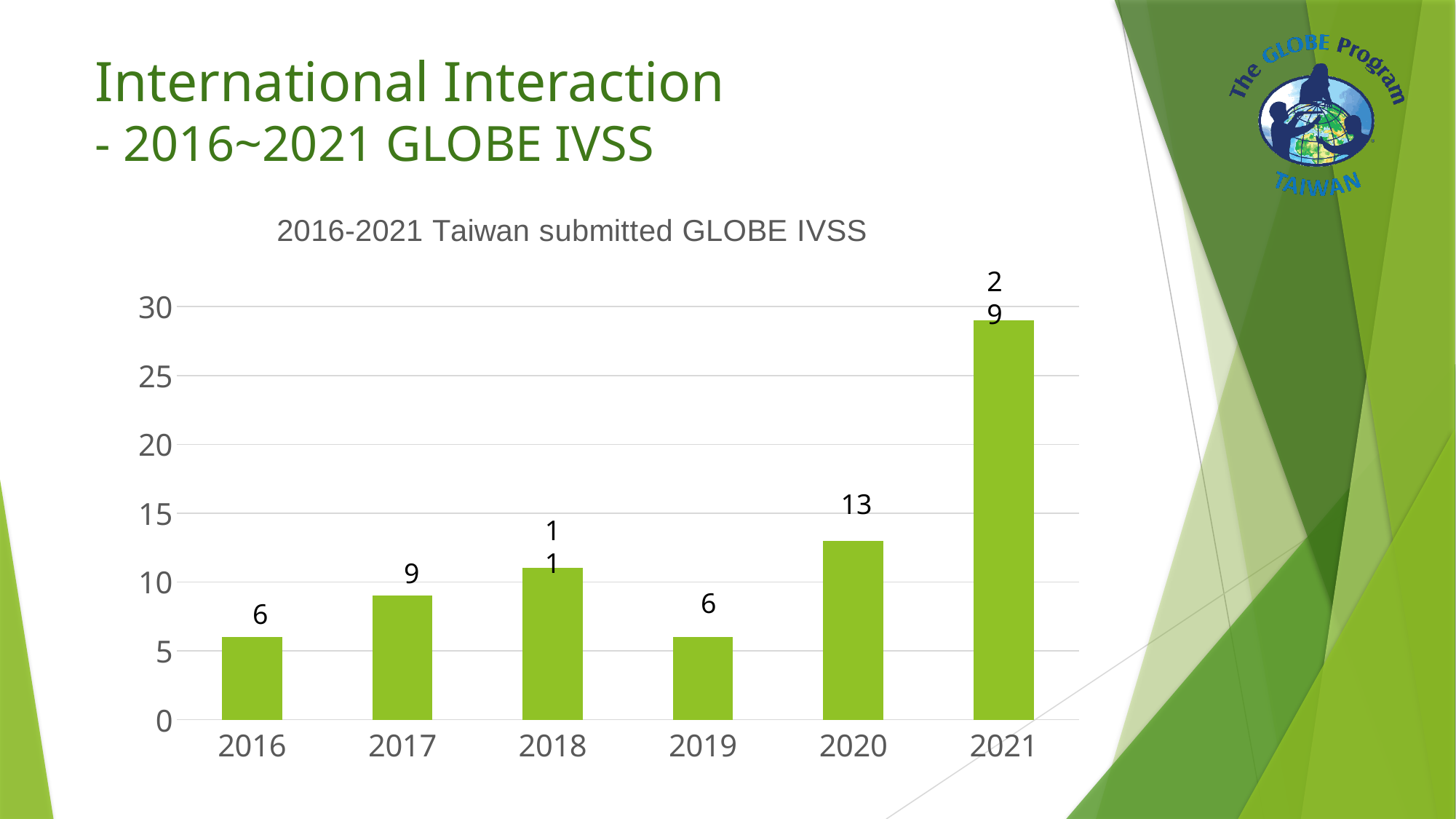
What is the difference between the values for 2021 and 2020? 16 Which years share the lowest value in the chart? 2016 and 2019 Which year has the highest value? 2021 What kind of chart is shown on the slide? bar chart How many GLOBE IVSS did Taiwan submit in 2017? 9 How many years are shown on the x axis of the chart? 6 What is the value for 2020? 13 What is the value for 2021? 29 What is the difference between the values for 2018 and 2016? 5 Which year has the larger value, 2018 or 2020? 2020 Is the value for 2021 greater or less than 25? greater What is the title of the chart? 2016-2021 Taiwan submitted GLOBE IVSS